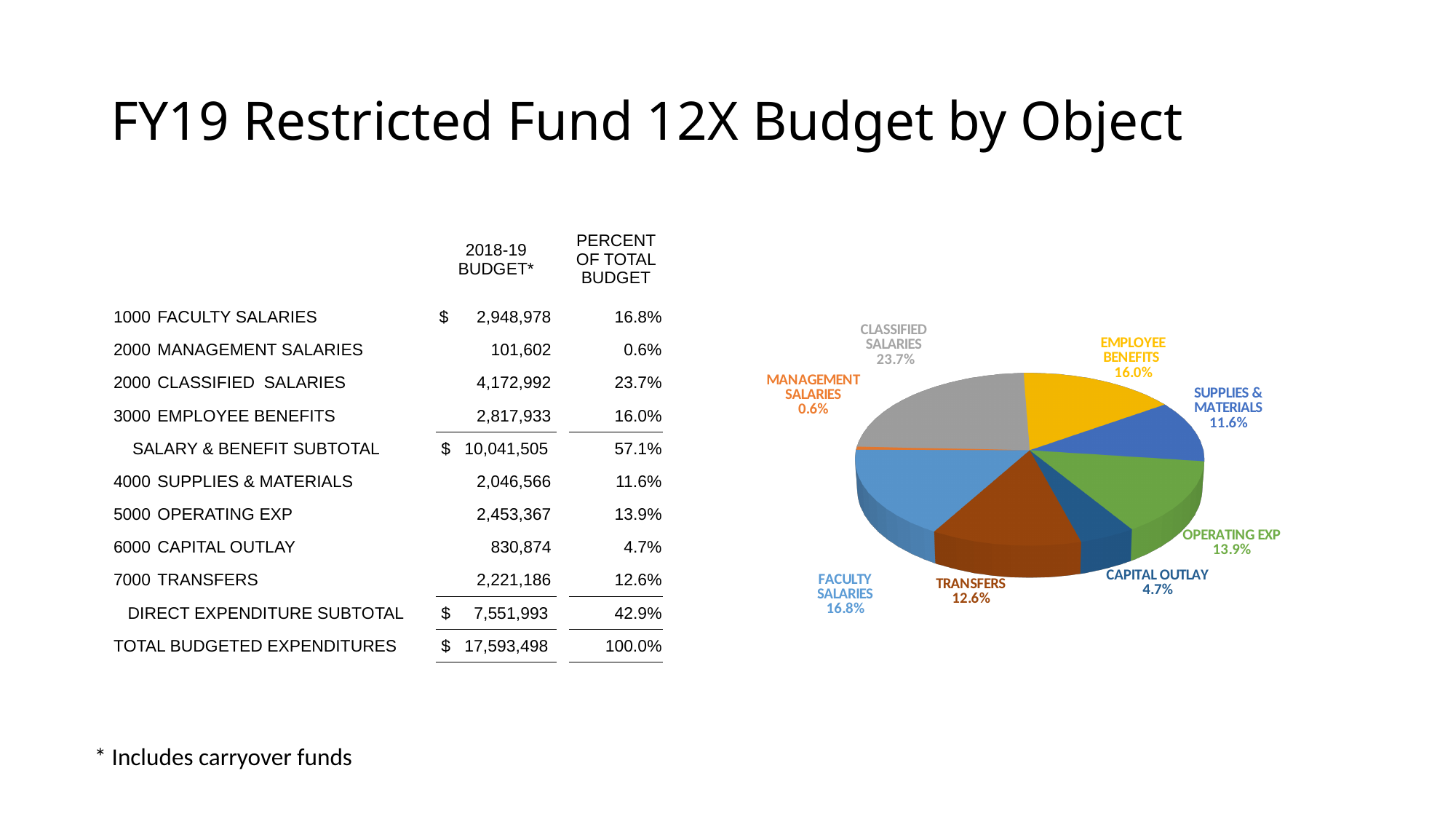
Which slice of the pie chart is the smallest? Management Salaries What share of the pie does Capital Outlay represent? 4.7% Which slice of the pie chart is the largest? Classified Salaries What share of the pie does Transfers represent? 12.6% Which is larger in the pie chart, Operating Exp or Supplies & Materials? Operating Exp How many slices does the pie chart have? 8 What kind of chart is shown on the slide? pie chart What is the difference in percentage points between Classified Salaries and Employee Benefits in the pie chart? 7.7 What share of the pie does Classified Salaries represent? 23.7% What colour is the Operating Exp slice in the pie chart? green What is the difference in percentage points between Faculty Salaries and Transfers in the pie chart? 4.2